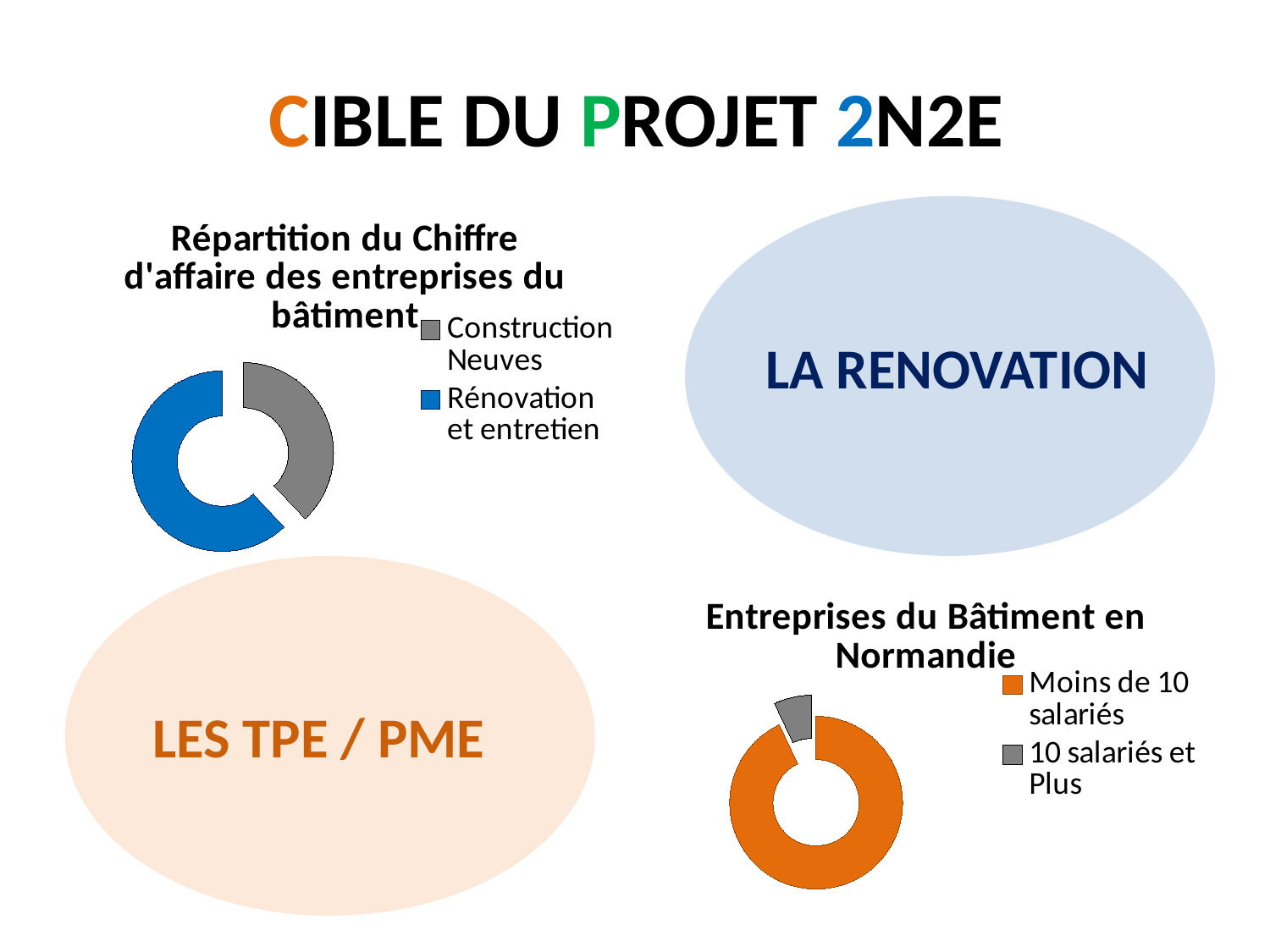
In the chart titled 'Entreprises du Bâtiment en Normandie', which category has the smallest share? 10 salariés et Plus In the chart titled 'Entreprises du Bâtiment en Normandie', which category has the largest share? Moins de 10 salariés In the chart titled 'Entreprises du Bâtiment en Normandie', what colour represents 10 salariés et Plus? grey In the chart titled 'Répartition du Chiffre d'affaire des entreprises du bâtiment', what colour represents Rénovation et entretien? blue In the chart titled 'Répartition du Chiffre d'affaire des entreprises du bâtiment', which is larger: Construction Neuves or Rénovation et entretien? Rénovation et entretien What kind of chart is the chart titled 'Répartition du Chiffre d'affaire des entreprises du bâtiment'? doughnut chart How many categories does the chart titled 'Répartition du Chiffre d'affaire des entreprises du bâtiment' show? 2 In the chart titled 'Entreprises du Bâtiment en Normandie', which is larger: Moins de 10 salariés or 10 salariés et Plus? Moins de 10 salariés In the chart titled 'Répartition du Chiffre d'affaire des entreprises du bâtiment', which category has the largest share? Rénovation et entretien In the chart titled 'Répartition du Chiffre d'affaire des entreprises du bâtiment', which category has the smallest share? Construction Neuves How many categories does the chart titled 'Entreprises du Bâtiment en Normandie' show? 2 What kind of chart is the chart titled 'Entreprises du Bâtiment en Normandie'? doughnut chart